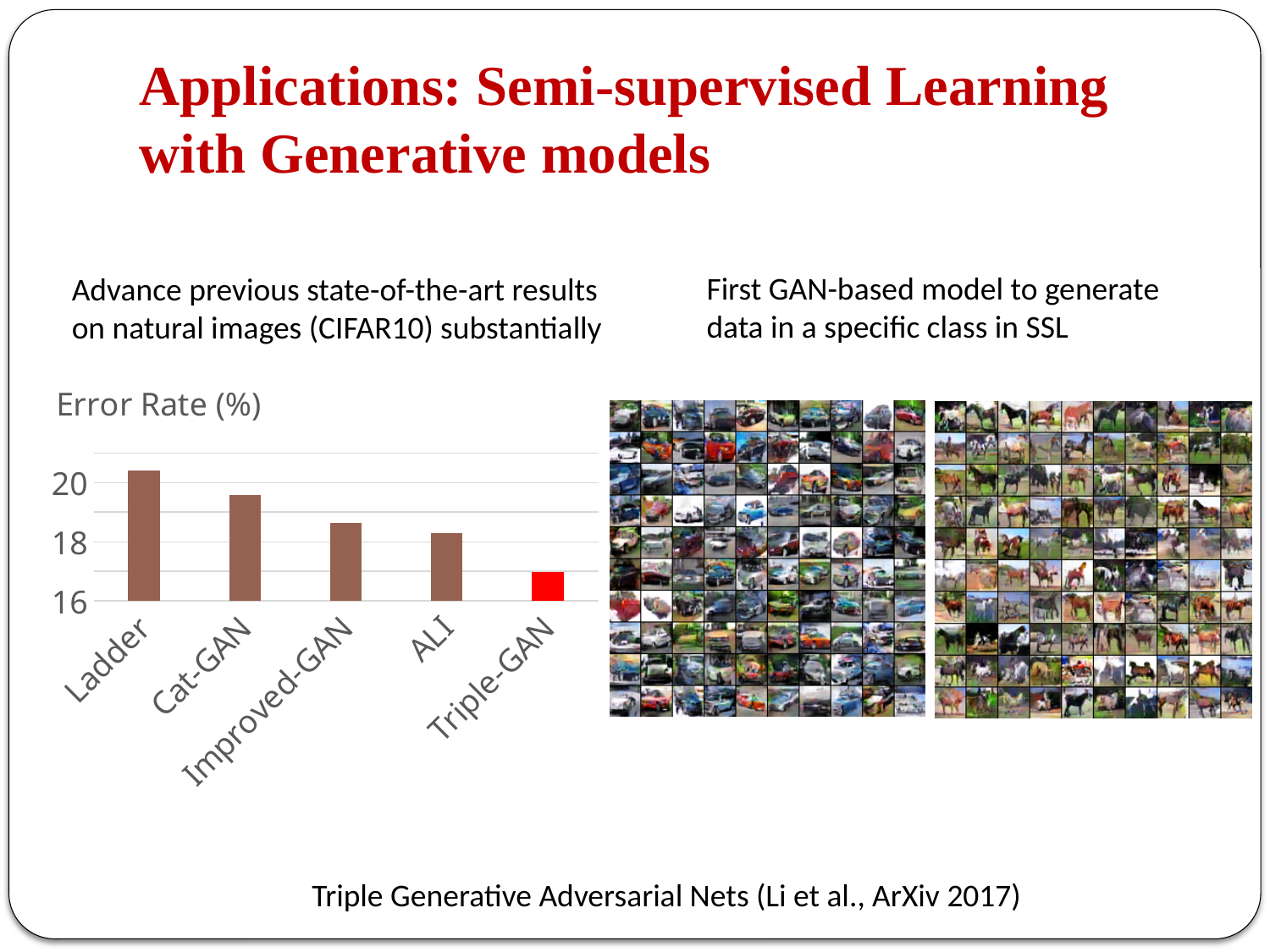
Is the error rate for Triple-GAN greater or less than 18? less Is the error rate for Ladder greater or less than 20? greater What kind of chart is shown on the slide? bar chart Which bar in the chart is coloured red? Triple-GAN Which method has the lowest error rate in the chart? Triple-GAN How many categories (methods) are shown on the x axis of the chart? 5 Is the error rate for Cat-GAN greater or less than 20? less What is the title of the chart? Error Rate (%) Do the error rates rise or fall moving from left to right along the x axis? fall Which has a higher error rate, Cat-GAN or Improved-GAN? Cat-GAN Which method has the highest error rate in the chart? Ladder